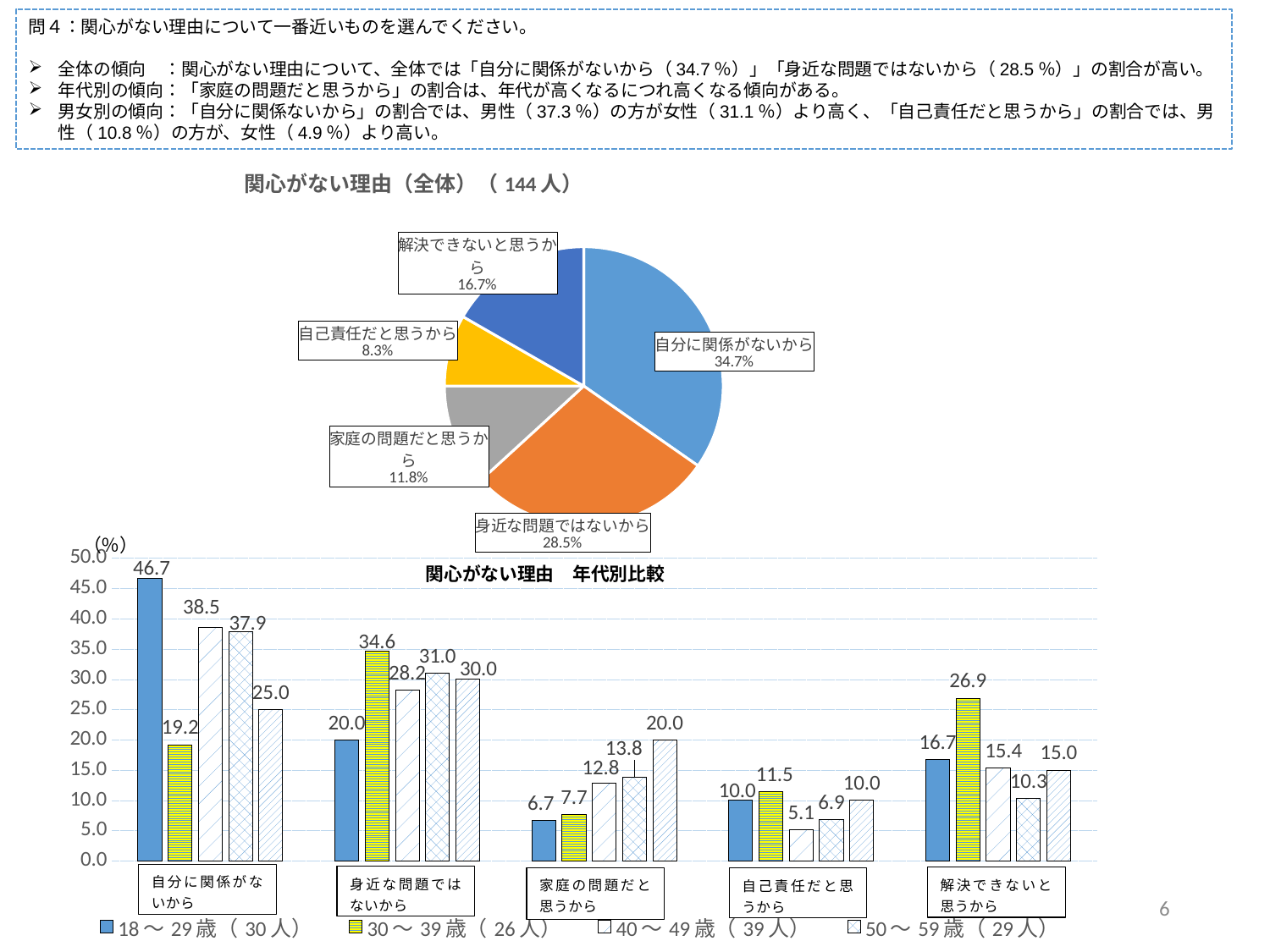
In the bar chart 関心がない理由 年代別比較, what is the difference between 18～29歳 and 30～39歳 in the category 自分に関係がないから? 27.5 In the pie chart 関心がない理由（全体）, how many slices are there? 5 In the bar chart 関心がない理由 年代別比較, which is larger for 解決できないと思うから: 18～29歳 or 30～39歳? 30～39歳 In the pie chart 関心がない理由（全体）, which reason has the smallest share? 自己責任だと思うから In the pie chart 関心がない理由（全体）, what is the difference between 自分に関係がないから and 身近な問題ではないから? 6.2 percentage points What kind of chart is the upper chart titled 関心がない理由（全体）? Pie chart In the bar chart 関心がない理由 年代別比較, how many reason categories are shown on the x axis? 5 In the bar chart 関心がない理由 年代別比較, what is the value for 18～29歳 in the category 自分に関係がないから? 46.7 In the pie chart 関心がない理由（全体）, what percentage is shown for 自分に関係がないから? 34.7% In the bar chart 関心がない理由 年代別比較, what is the value for 40～49歳 in the category 自己責任だと思うから? 5.1 In the pie chart 関心がない理由（全体）, which reason has the largest share? 自分に関係がないから In the bar chart 関心がない理由 年代別比較, what is the value for 30～39歳 in the category 身近な問題ではないから? 34.6